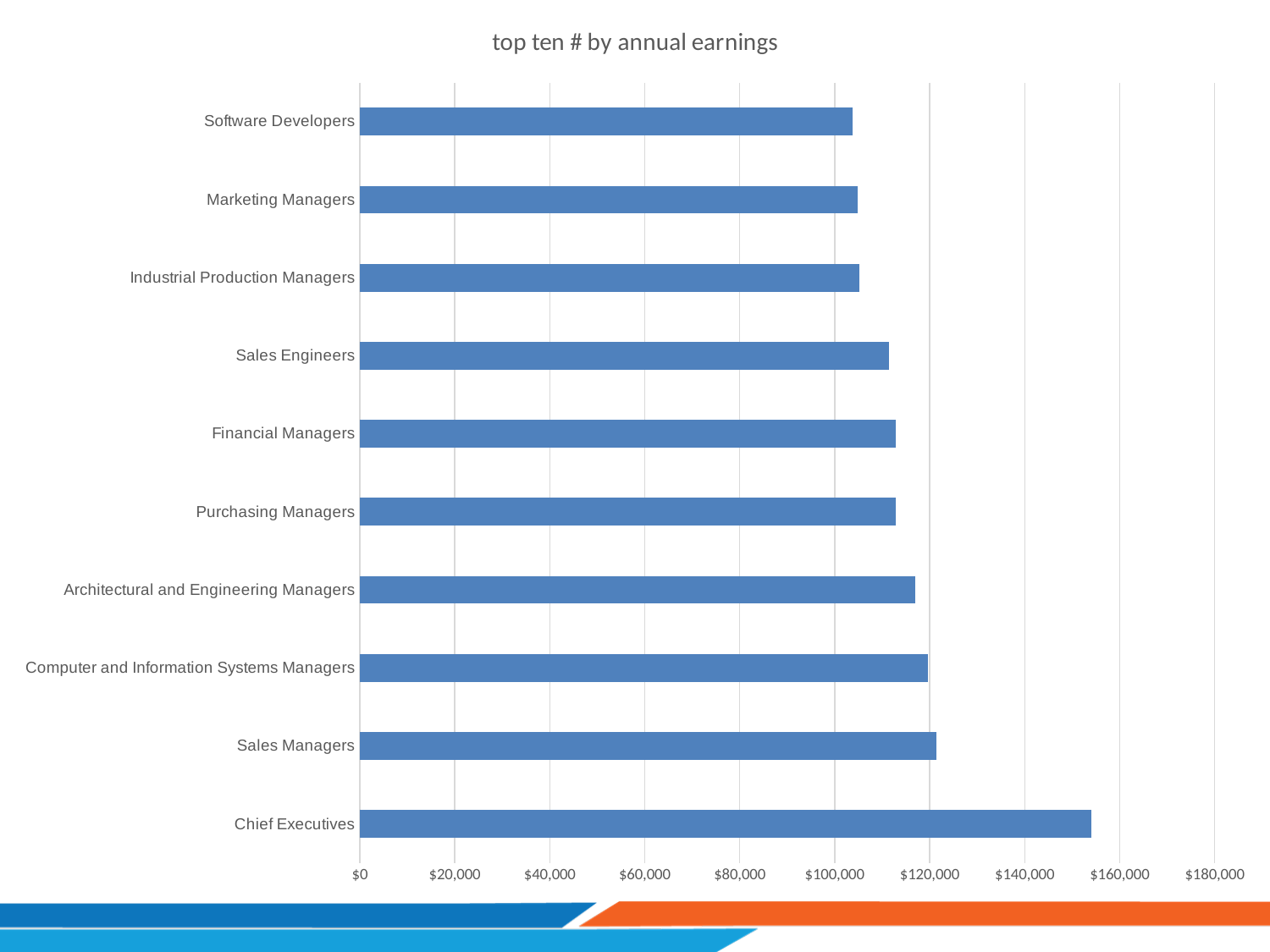
Is the value for Chief Executives greater or less than $160,000? less Is the value for Chief Executives greater or less than $140,000? greater What is the title of the chart? top ten # by annual earnings Is the value for Architectural and Engineering Managers greater or less than $120,000? less What kind of chart is shown on the slide? bar chart Which occupation has the highest annual earnings in the chart? Chief Executives Which has higher annual earnings, Chief Executives or Sales Managers? Chief Executives How many occupations are plotted in the chart? 10 Which has higher annual earnings, Sales Engineers or Software Developers? Sales Engineers